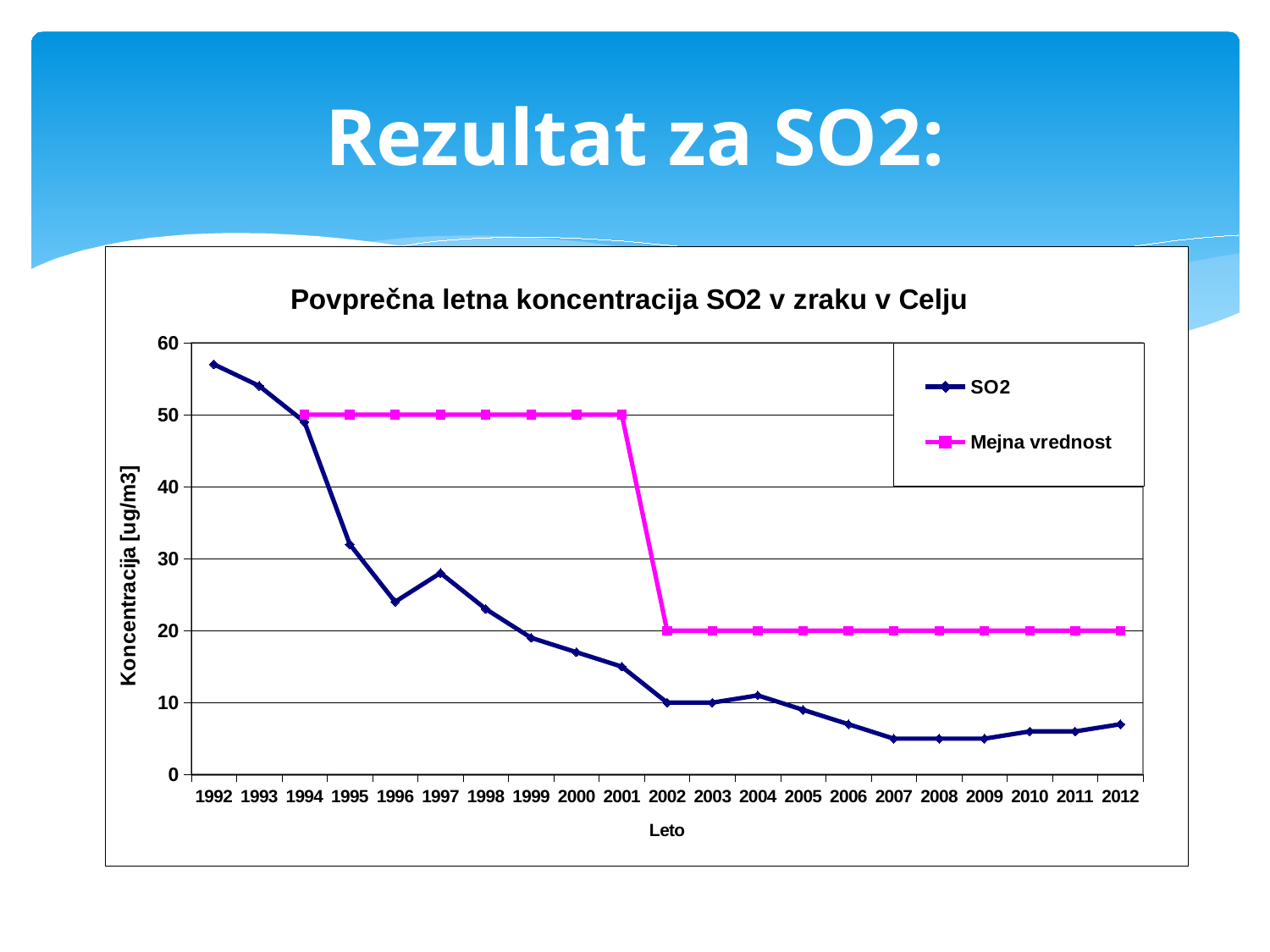
How many series does the legend list? 2 How many years are plotted along the x axis? 21 What is the title of the chart? Povprečna letna koncentracija SO2 v zraku v Celju What is the value of Mejna vrednost in 2010? 20 Which is larger in 2001, the SO2 value or the Mejna vrednost value? Mejna vrednost What kind of chart is shown on the slide? line chart Is the SO2 value for 1992 greater or less than 50? greater Is the SO2 value for 2012 greater or less than 10? less Does the SO2 concentration generally rise or fall from 1992 to 2012? fall What is the value of Mejna vrednost in 1998? 50 By how much does Mejna vrednost drop between 2001 and 2002? 30 In which year is the SO2 concentration highest? 1992